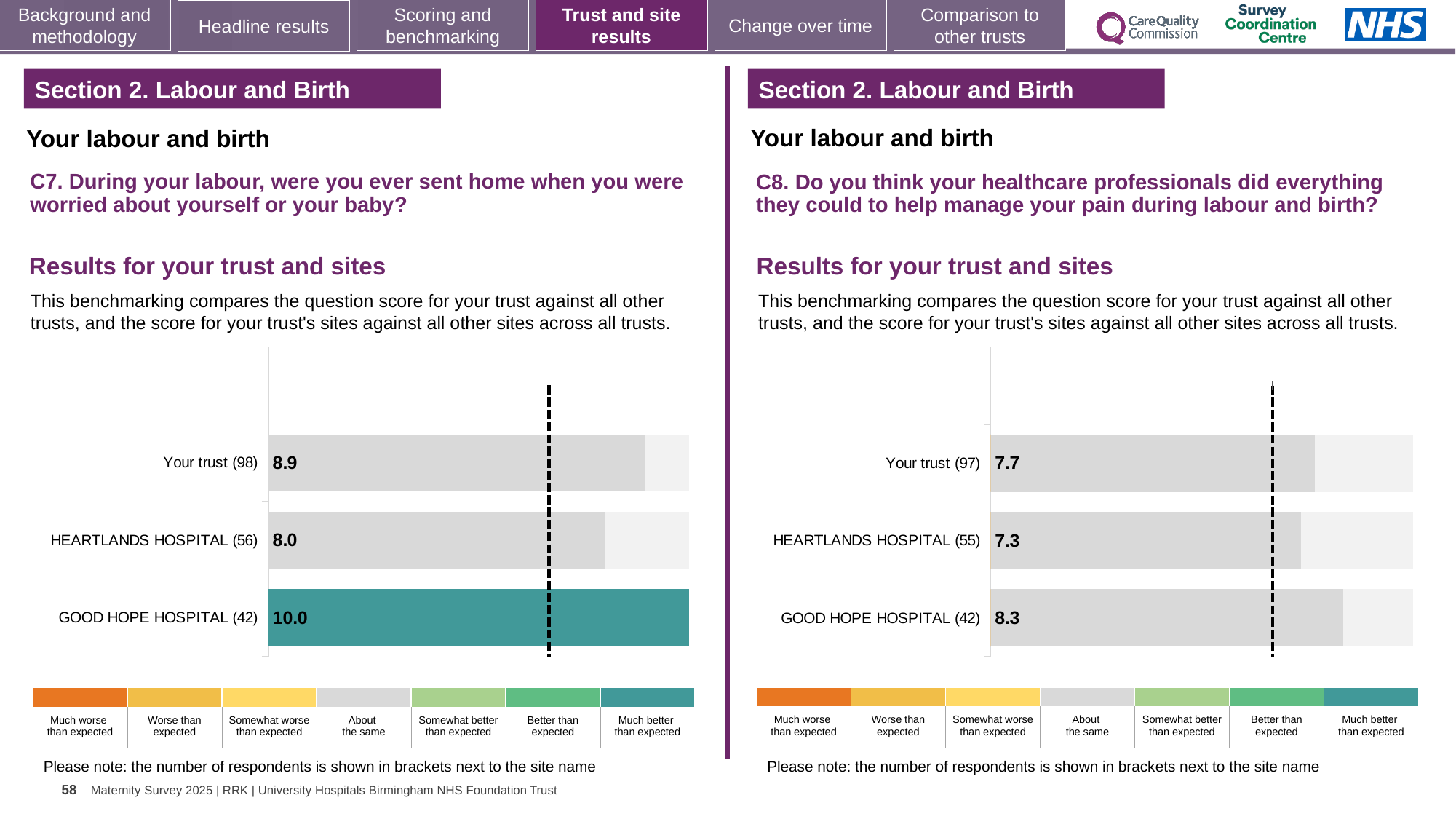
In the C8 chart on the right, what is the score for Your trust? 7.7 In the C8 chart on the right, which site or trust has the lowest score? HEARTLANDS HOSPITAL In the C7 chart on the left, how many respondents are shown in brackets for GOOD HOPE HOSPITAL? 42 In the C7 chart on the left, what is the score for Your trust? 8.9 How many bars are plotted in the C7 chart on the left? 3 In the C8 chart on the right, what is the score for HEARTLANDS HOSPITAL? 7.3 In the C7 chart on the left, what is the difference between the scores for GOOD HOPE HOSPITAL and HEARTLANDS HOSPITAL? 2.0 What type of chart is used for the C8 results on the right? Bar chart In the C7 chart on the left, which site or trust has the highest score? GOOD HOPE HOSPITAL In the C8 chart on the right, which has the larger score, Your trust or GOOD HOPE HOSPITAL? GOOD HOPE HOSPITAL In the C7 chart on the left, what is the score for GOOD HOPE HOSPITAL? 10.0 In the C8 chart on the right, what is the difference between the scores for GOOD HOPE HOSPITAL and Your trust? 0.6